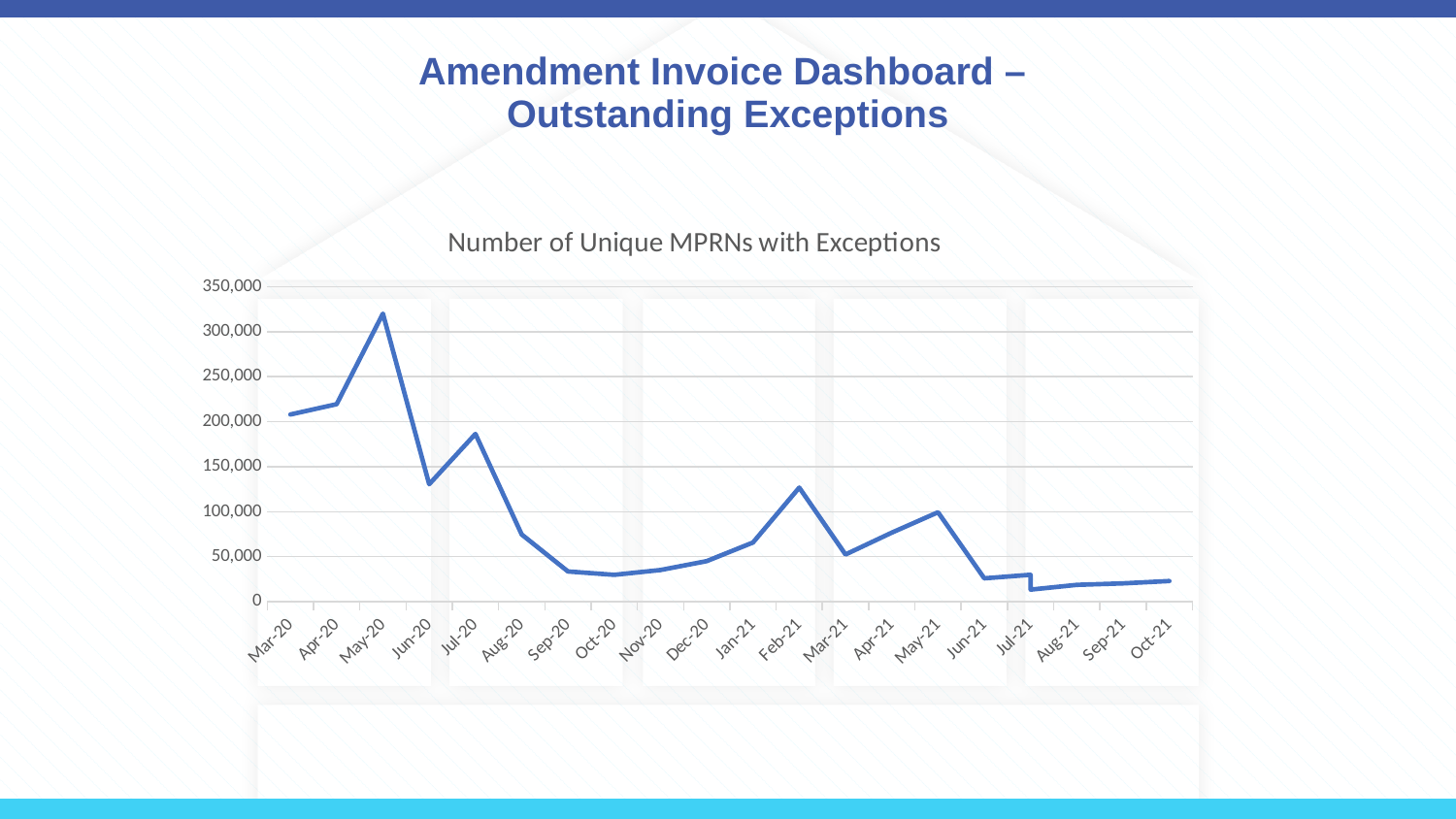
Is the value for Jun-20 greater or less than 100,000? greater What is the title of the chart? Number of Unique MPRNs with Exceptions Which is larger, the value for Feb-21 or the value for Mar-21? Feb-21 How many months are plotted along the x axis of the chart? 20 Is the value for Oct-21 greater or less than 50,000? less Overall, do the values rise or fall from Mar-20 to Oct-21? fall Which month has the highest number of unique MPRNs with exceptions? May-20 Is the value for Sep-20 greater or less than 50,000? less Which is larger, the value for May-20 or the value for Jul-20? May-20 What kind of chart is shown on the slide? line chart